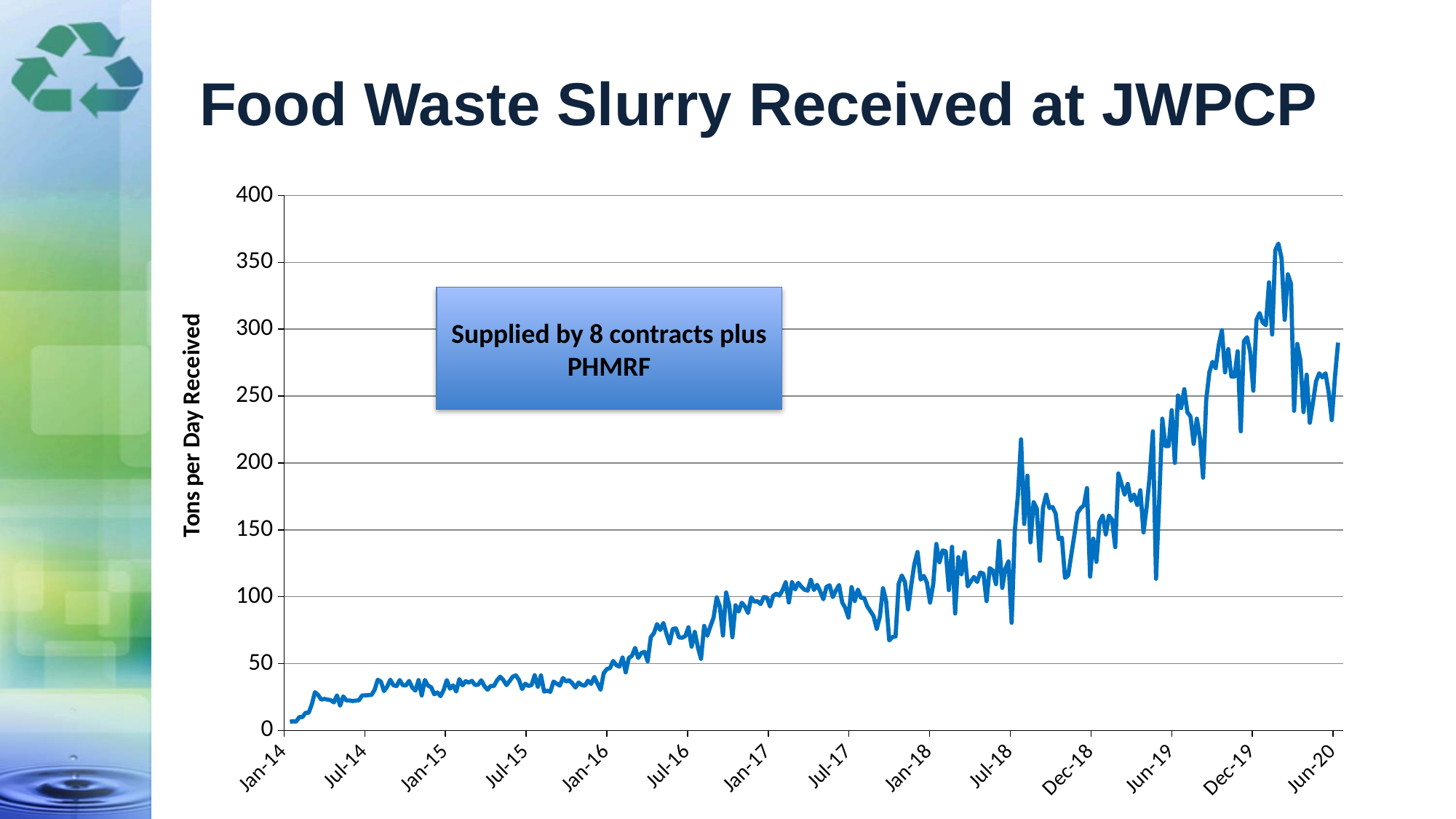
What is the title of the chart on the slide? Food Waste Slurry Received at JWPCP Is the value at Jul-16 greater or less than 100? less Overall, do the values rise or fall from Jan-14 to Jun-20? rise Is the value at Jan-15 greater or less than 50? less Is the value at Jan-14 greater or less than 50? less What is the maximum value shown on the vertical axis? 400 What kind of chart is shown on the slide? line chart What is the label on the vertical axis of the chart? Tons per Day Received